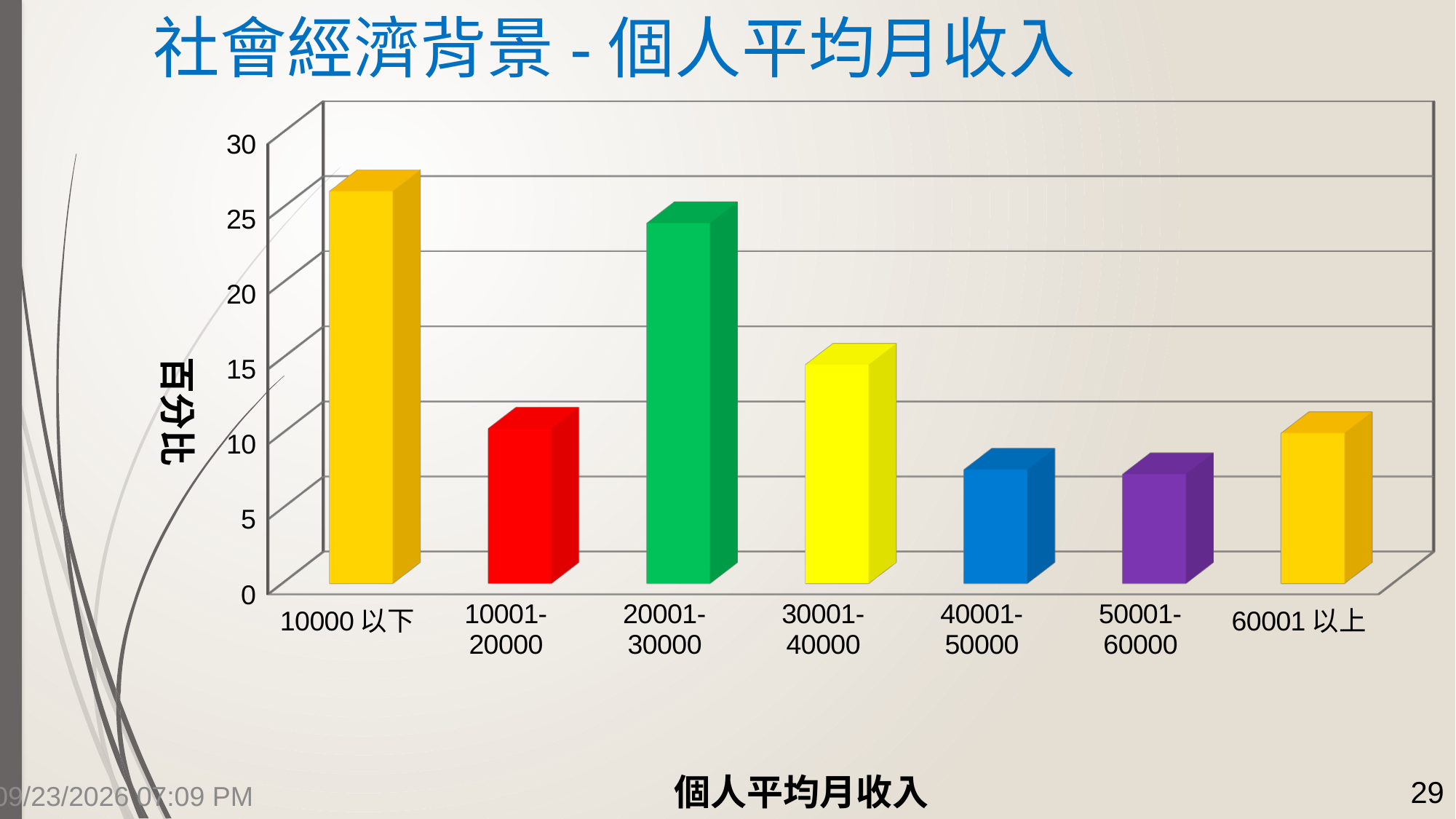
What is the label on the vertical axis of the chart? 百分比 Which has a higher percentage, 20001-30000 or 30001-40000? 20001-30000 How many income categories are shown on the x axis? 7 Is the value for 30001-40000 greater or less than 10? greater Is the value for 40001-50000 greater or less than 10? less Which has a higher percentage, 10001-20000 or 40001-50000? 10001-20000 What kind of chart is shown on the slide? bar chart Is the value for 10000 以下 greater or less than 25? greater Which income category has the highest percentage? 10000 以下